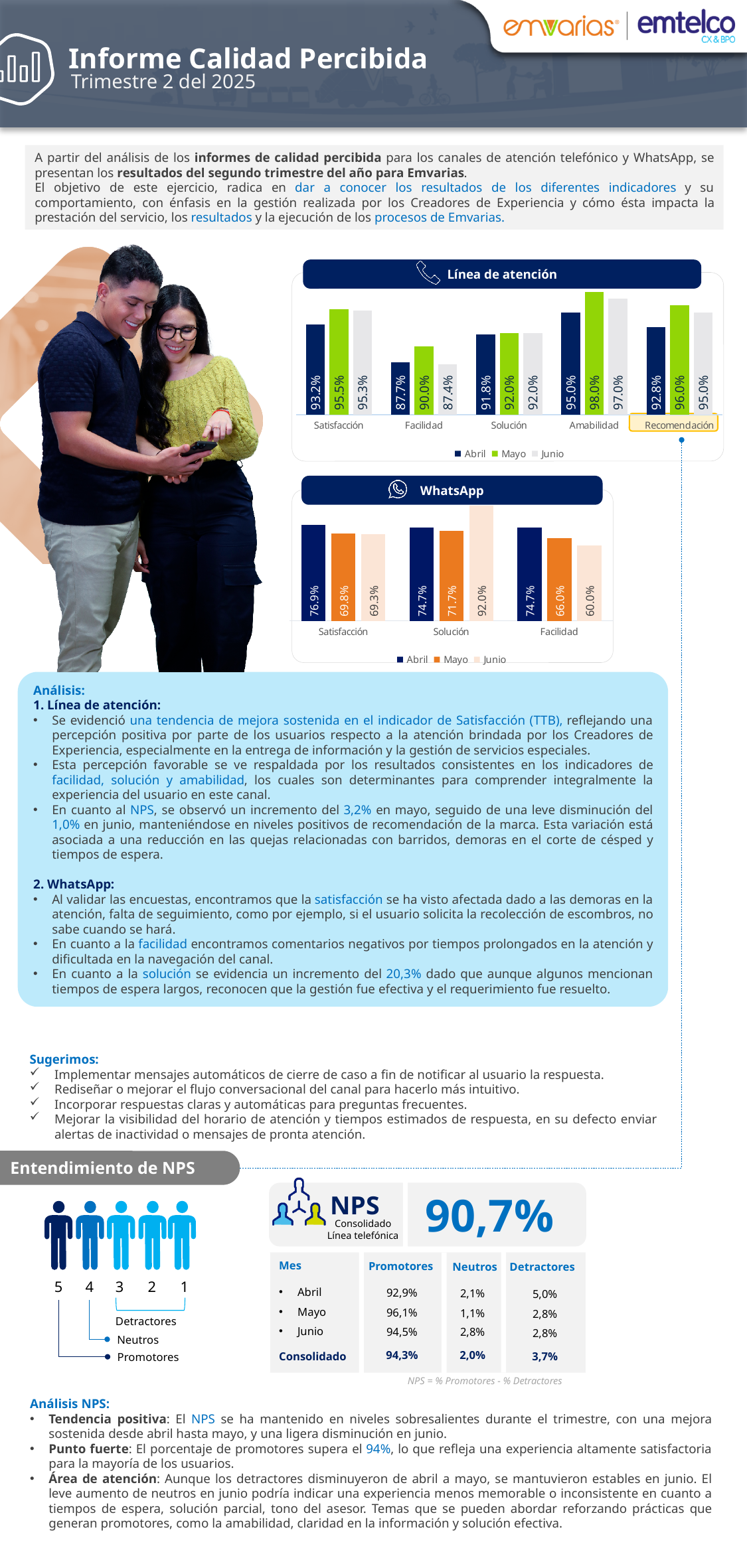
In the 'WhatsApp' chart, what is the difference between the Junio and Mayo values for Solución? 20,3% In the 'Línea de atención' chart, what is the value for Amabilidad in Mayo? 98,0% In the 'Línea de atención' chart, which category has the highest value in Mayo? Amabilidad In the 'WhatsApp' chart, how many series does the legend list? 3 In the 'WhatsApp' chart, what is the value for Facilidad in Mayo? 66,0% In the 'Línea de atención' chart, how many categories are shown on the x axis? 5 In the 'WhatsApp' chart, which is larger: Satisfacción in Abril or Satisfacción in Junio? Satisfacción in Abril In the 'WhatsApp' chart, what is the value for Solución in Junio? 92,0% In the 'Línea de atención' chart, what is the difference between the Mayo and Abril values for Recomendación? 3,2% In the 'Línea de atención' chart, what is the value for Facilidad in Abril? 87,7% What type of chart is the 'WhatsApp' chart? Bar chart In the 'Línea de atención' chart, which category has the lowest value in Junio? Facilidad